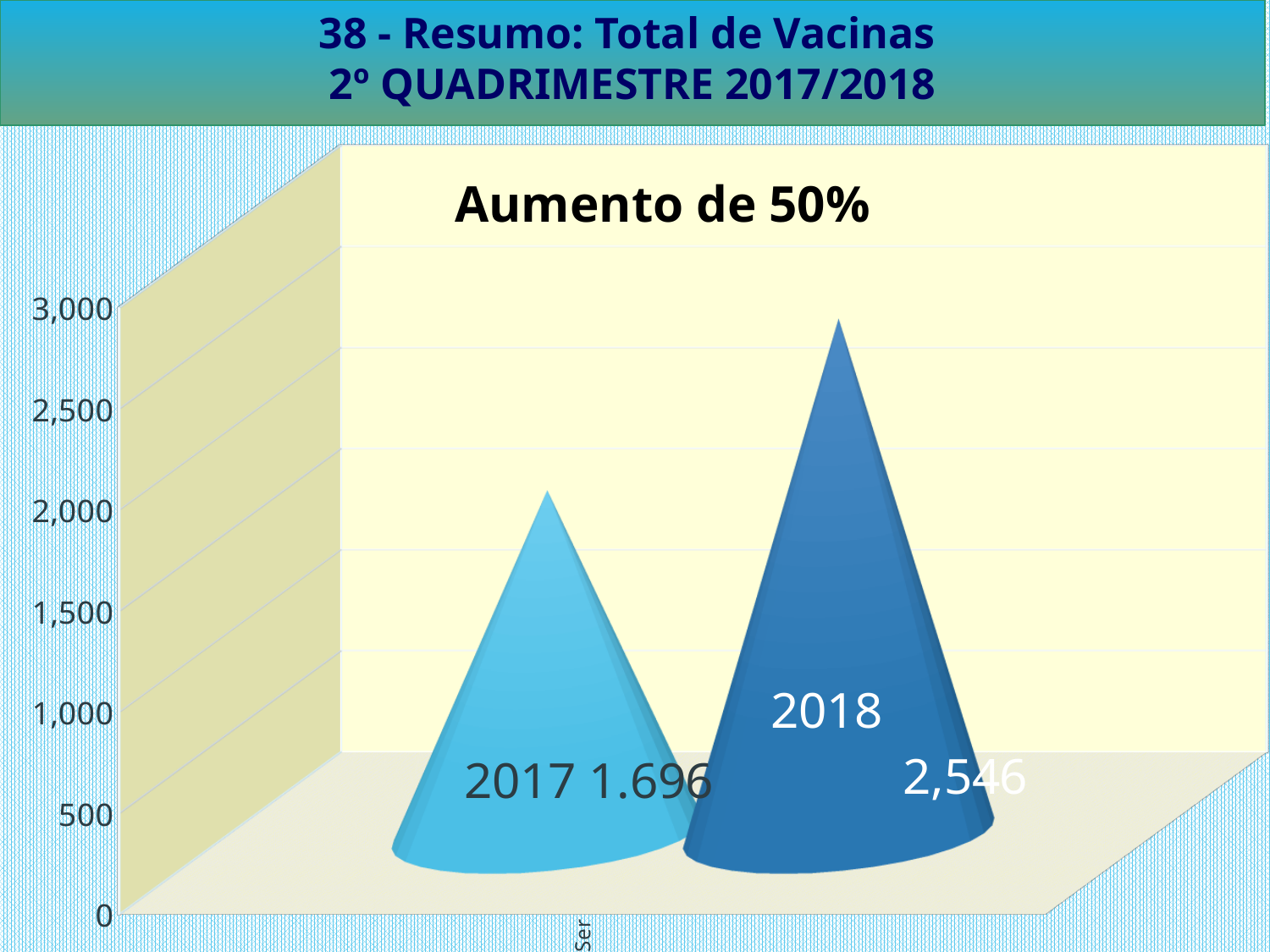
Do the values rise or fall from 2017 to 2018? rise Which year has the higher value? 2018 What is the value shown for 2017? 1.696 What is the difference between the 2018 value and the 2017 value? 850 Is the value for 2017 greater or less than 2,000? less What is the title printed inside the chart area? Aumento de 50% What is the value shown for 2018? 2,546 What kind of chart is shown on the slide? bar chart How many years are plotted in the chart? 2 Which year has the lower value? 2017 Is the value for 2018 larger than the value for 2017? Yes Is the value for 2018 greater or less than 2,000? greater